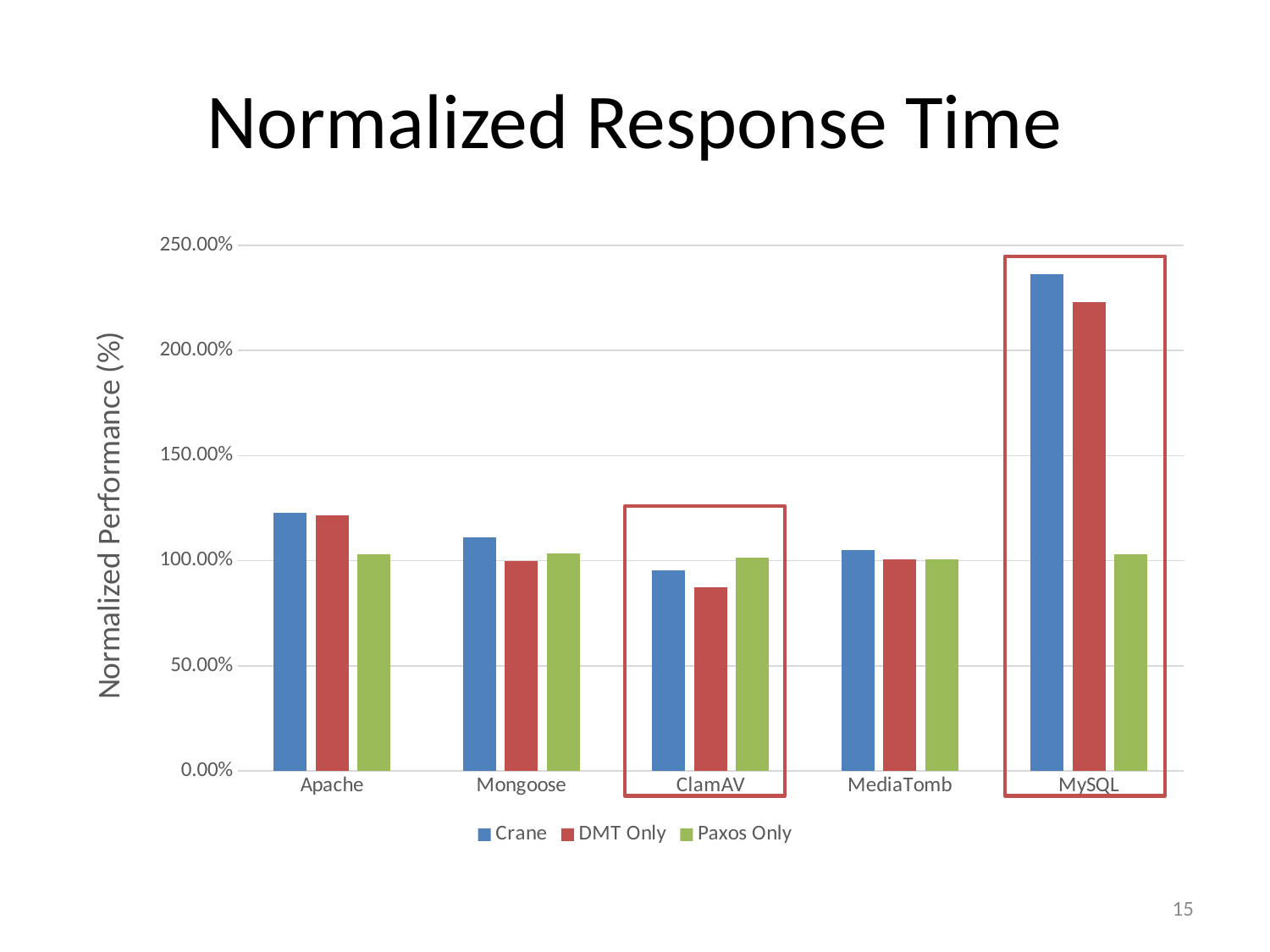
Which category has the highest Crane value? MySQL For ClamAV, which is larger: the Paxos Only value or the DMT Only value? Paxos Only For MySQL, which is larger: the Crane value or the Paxos Only value? Crane What kind of chart is shown on the slide? bar chart Is the Crane value for MySQL greater or less than 200.00%? greater What is the label of the y axis? Normalized Performance (%) Which category has the lowest DMT Only value? ClamAV Is the Crane value for Apache greater or less than 100.00%? greater How many application categories are shown on the x axis? 5 How many series does the legend list? 3 Is the DMT Only value for ClamAV greater or less than 100.00%? less What is the title of the chart? Normalized Response Time